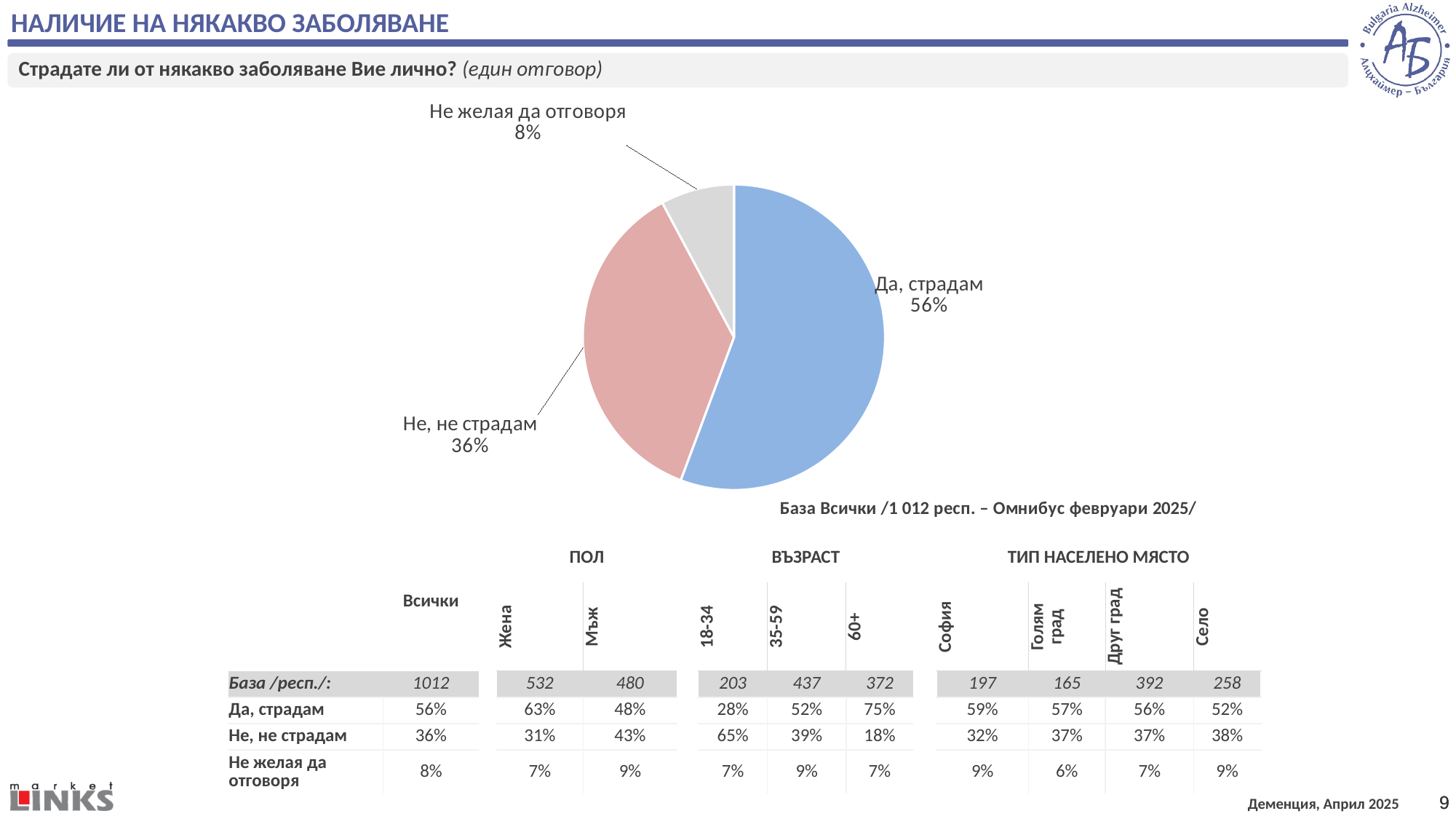
How many slices does the pie chart have? 3 Which slice of the pie chart is the largest? Да, страдам What colour is the "Да, страдам" slice of the pie chart? blue What is the difference between the shares of "Да, страдам" and "Не, не страдам"? 20% What share of the pie does "Не, не страдам" have? 36% What colour is the "Не, не страдам" slice of the pie chart? pink Which is larger in the pie chart, "Не, не страдам" or "Не желая да отговоря"? Не, не страдам What is the difference between the shares of "Не, не страдам" and "Не желая да отговоря"? 28% What kind of chart is shown on the slide? pie chart What share of the pie does "Да, страдам" have? 56% Which slice of the pie chart is the smallest? Не желая да отговоря What share of the pie does "Не желая да отговоря" have? 8%